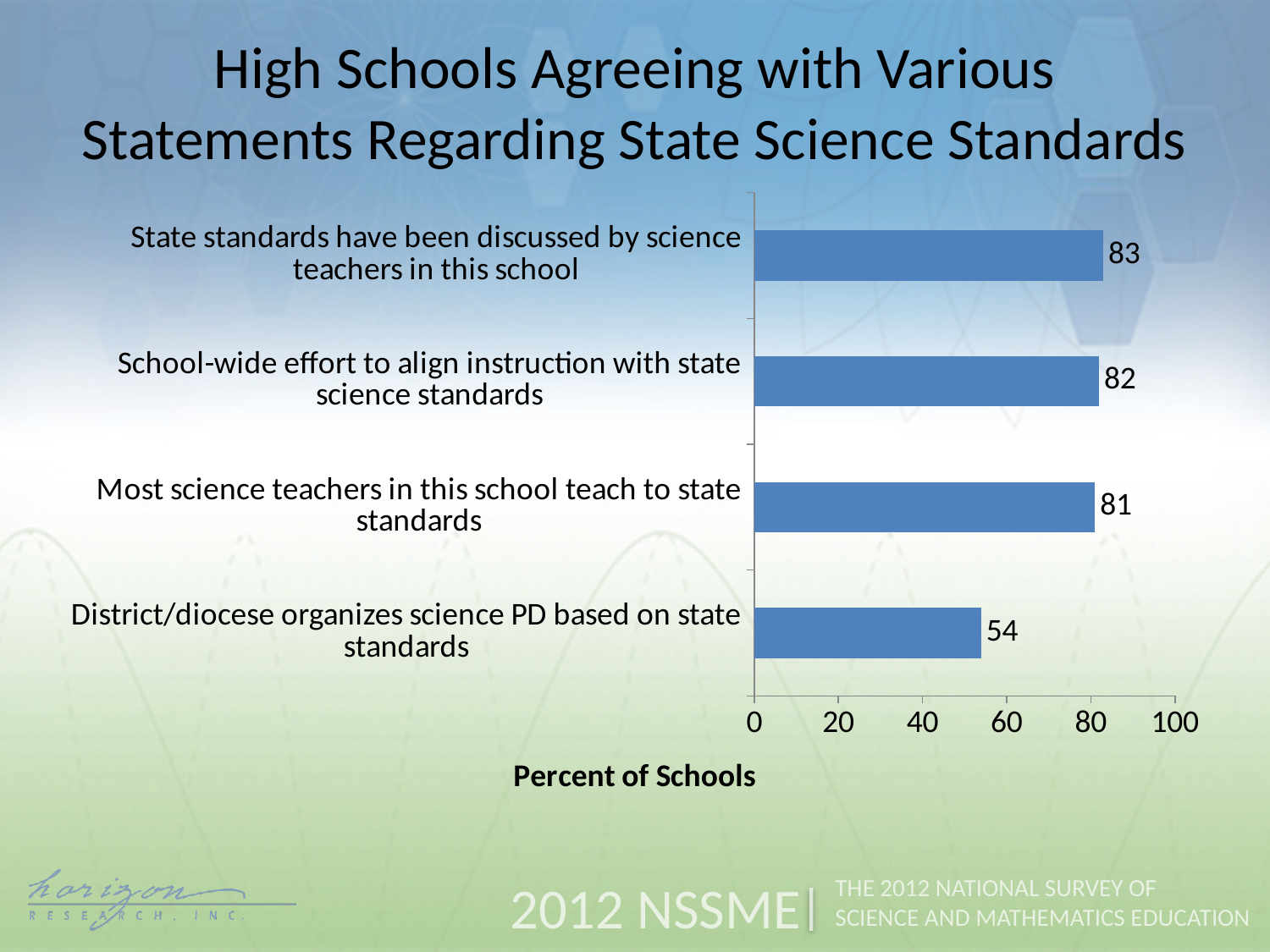
What is the value for 'Most science teachers in this school teach to state standards'? 81 What is the label of the horizontal axis? Percent of Schools How many statements are shown in the chart? 4 What percent of high schools agree that the district/diocese organizes science PD based on state standards? 54 What is the difference between the values for 'State standards have been discussed by science teachers in this school' and 'District/diocese organizes science PD based on state standards'? 29 What kind of chart is shown on the slide? bar chart What percent of high schools agree that state standards have been discussed by science teachers in this school? 83 Which statement has the highest percent of schools agreeing? State standards have been discussed by science teachers in this school Is the value for 'District/diocese organizes science PD based on state standards' greater or less than 60? less Which is larger: the value for 'School-wide effort to align instruction with state science standards' or 'District/diocese organizes science PD based on state standards'? School-wide effort to align instruction with state science standards Which statement has the lowest percent of schools agreeing? District/diocese organizes science PD based on state standards What is the value for 'School-wide effort to align instruction with state science standards'? 82